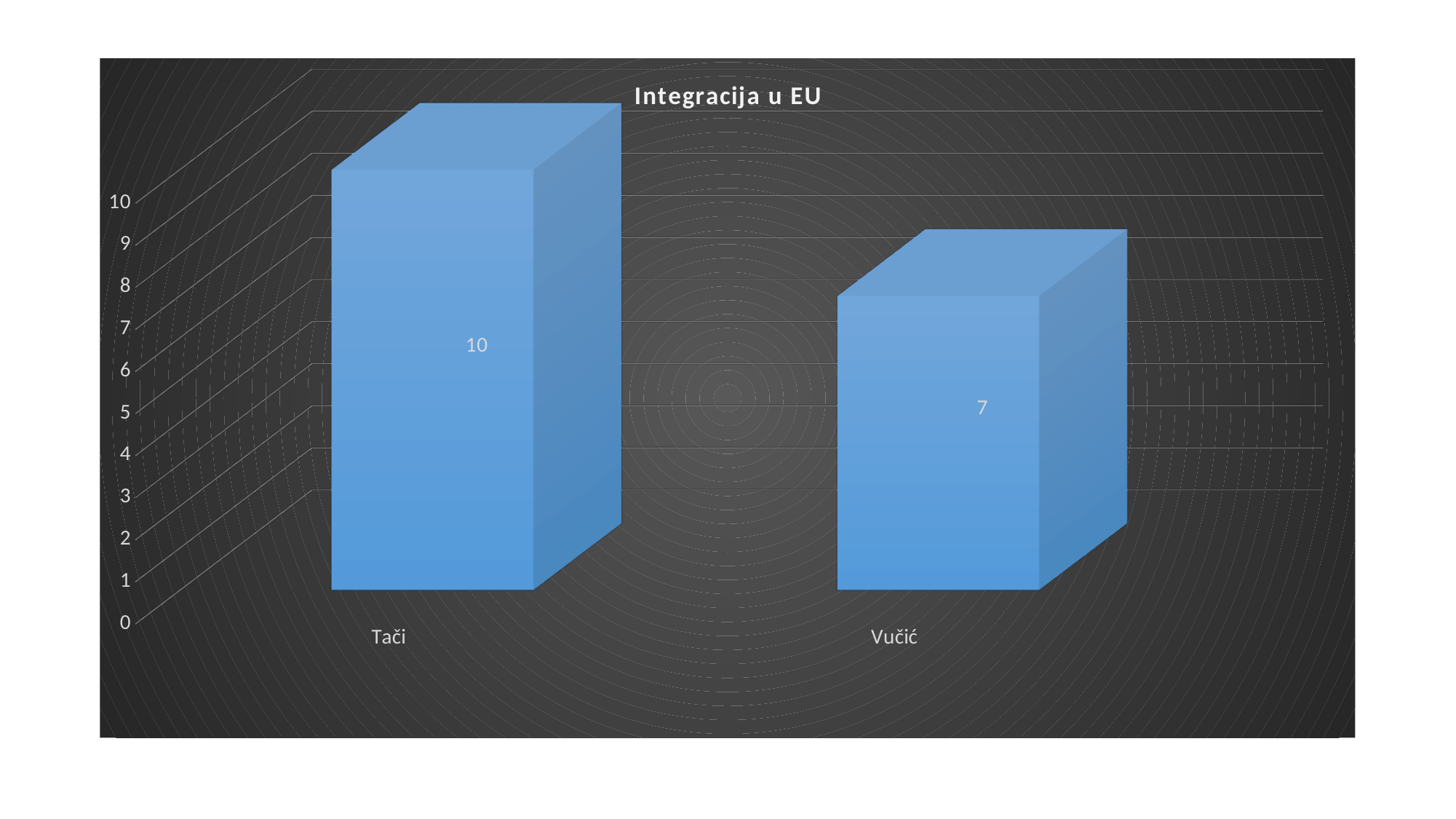
How many categories are shown in the chart? 2 What kind of chart is shown on the slide? bar chart Which category has the highest value? Tači Is the value for Vučić greater or less than 5? greater What is the value for Tači? 10 What is the highest value shown on the vertical axis? 10 What is the title of the chart? Integracija u EU Which category has the lowest value? Vučić What is the value for Vučić? 7 What is the difference between the values for Tači and Vučić? 3 Which is larger, the value for Tači or the value for Vučić? Tači